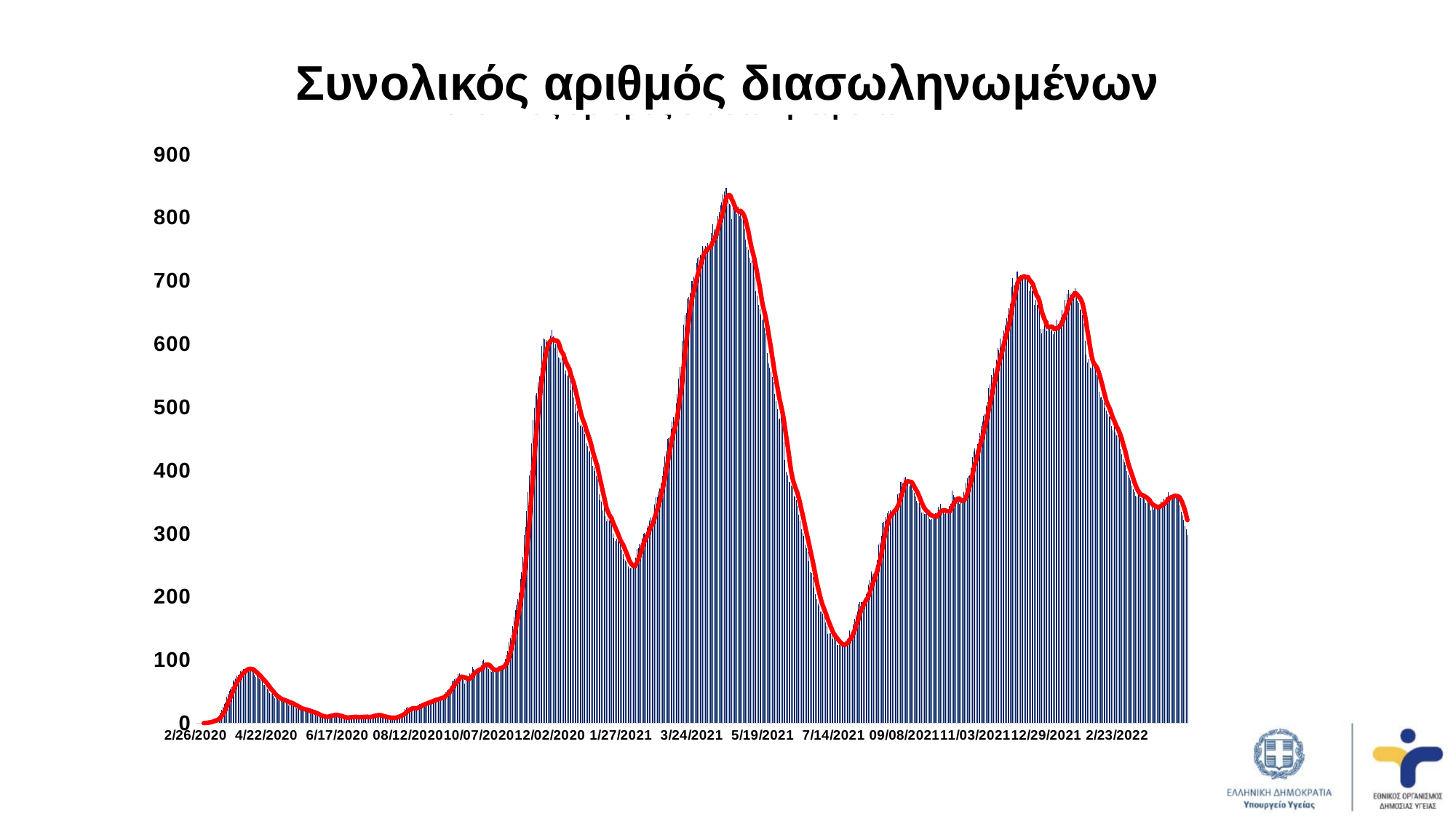
What colour is the smoothed line drawn over the bars? Red What is the title of the chart? Συνολικός αριθμός διασωληνωμένων What kind of chart is shown on the slide? Bar chart with a line overlay Is the value at 3/24/2021 greater or less than 500? greater Is the value at the highest peak of the chart greater or less than 800? greater Which is higher: the peak near 12/02/2020 or the peak near 12/29/2021? The peak near 12/29/2021 Is the value at 4/22/2020 greater or less than 100? less What is the highest value shown on the vertical axis? 900 Between 5/19/2021 and 7/14/2021, do the values rise or fall? Fall